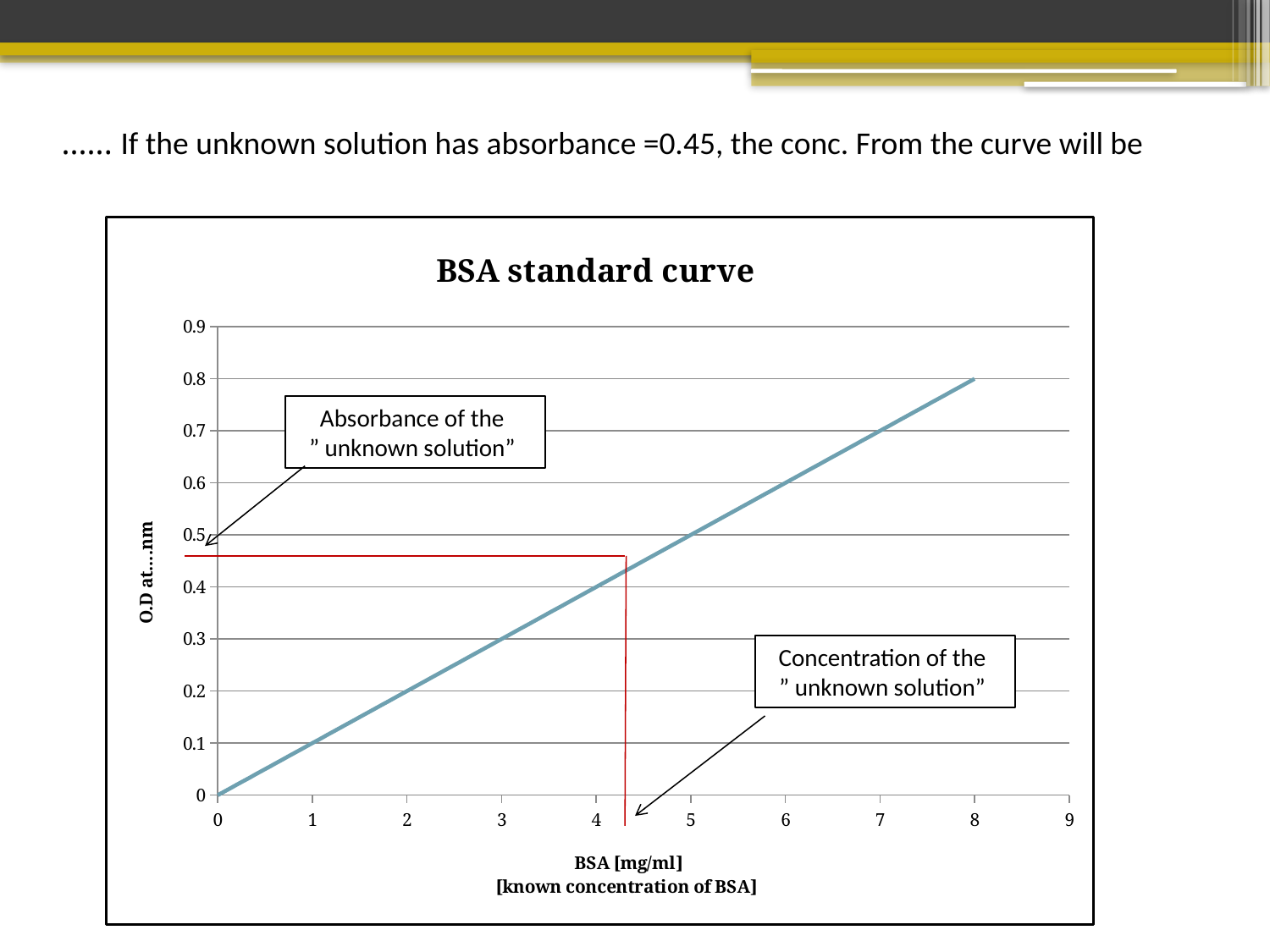
What is the title of the chart? BSA standard curve What is the O.D value at the point where the line ends, at a BSA concentration of 8 mg/ml? 0.8 What is the highest value shown on the y axis of the chart? 0.9 What kind of chart is shown on the slide? line chart What is the label of the x axis of the chart? BSA [mg/ml] [known concentration of BSA] Which has a higher O.D value on the line: a BSA concentration of 7 mg/ml or 3 mg/ml? 7 mg/ml Does the O.D value rise or fall as the BSA concentration increases along the x axis? rise Is the O.D value of the line at a BSA concentration of 4 mg/ml greater or less than 0.5? less Is the O.D value of the line at a BSA concentration of 6 mg/ml greater or less than 0.5? greater According to the slide text, what is the absorbance of the unknown solution? 0.45 Is the O.D value of the line at a BSA concentration of 7 mg/ml greater or less than 0.6? greater